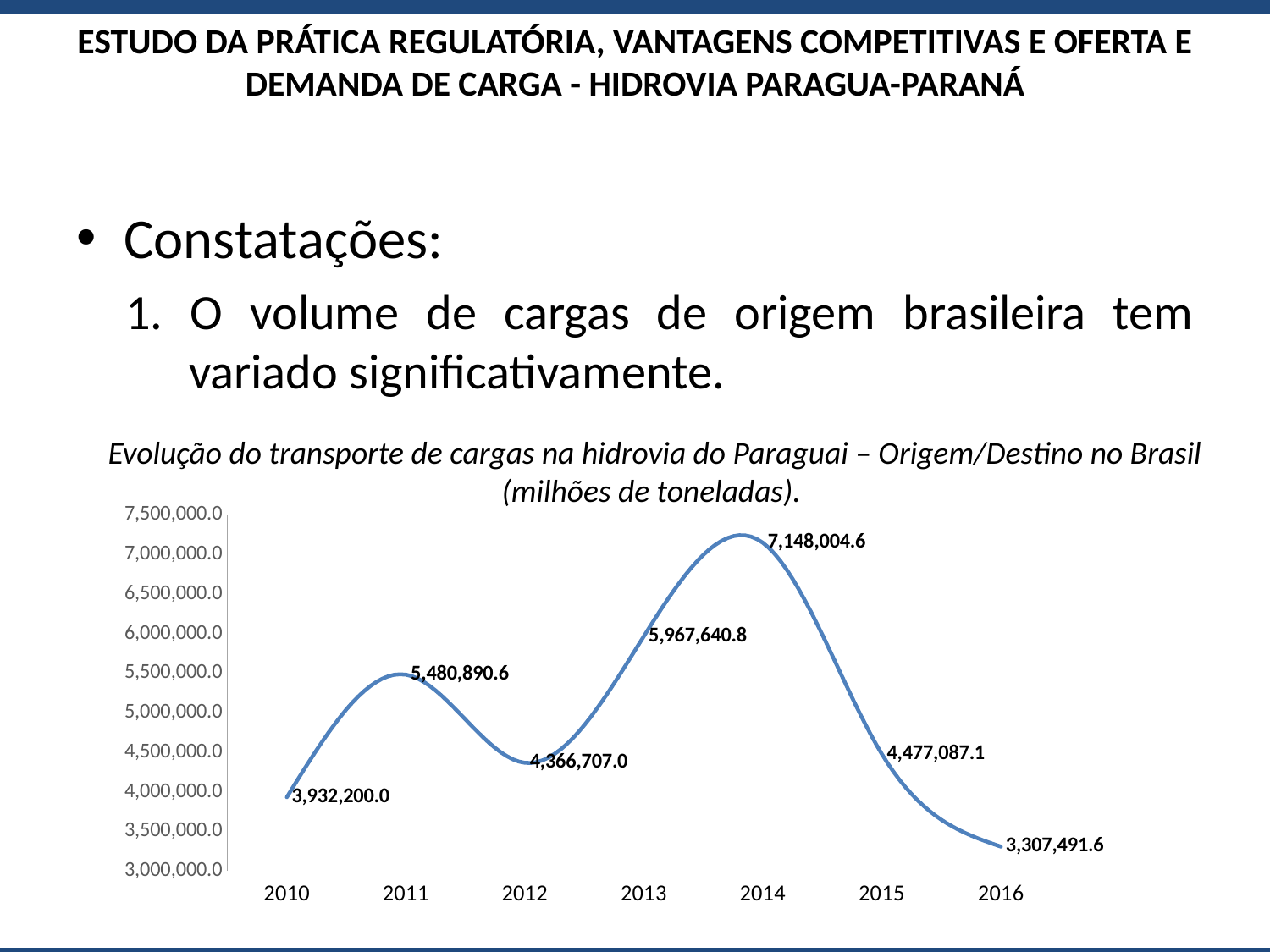
What is the value for 2014? 7,148,004.6 What is the difference between the values for 2014 and 2016? 3,840,513.0 How many years are plotted on the chart? 7 Which is larger, the value for 2013 or the value for 2011? 2013 Which year has the lowest value? 2016 What is the value for 2016? 3,307,491.6 What kind of chart is shown? line chart What is the value for 2012? 4,366,707.0 Is the value for 2015 greater or less than 5,000,000.0? less What is the difference between the values for 2011 and 2010? 1,548,690.6 Which year has the highest value? 2014 What is the value for 2010? 3,932,200.0